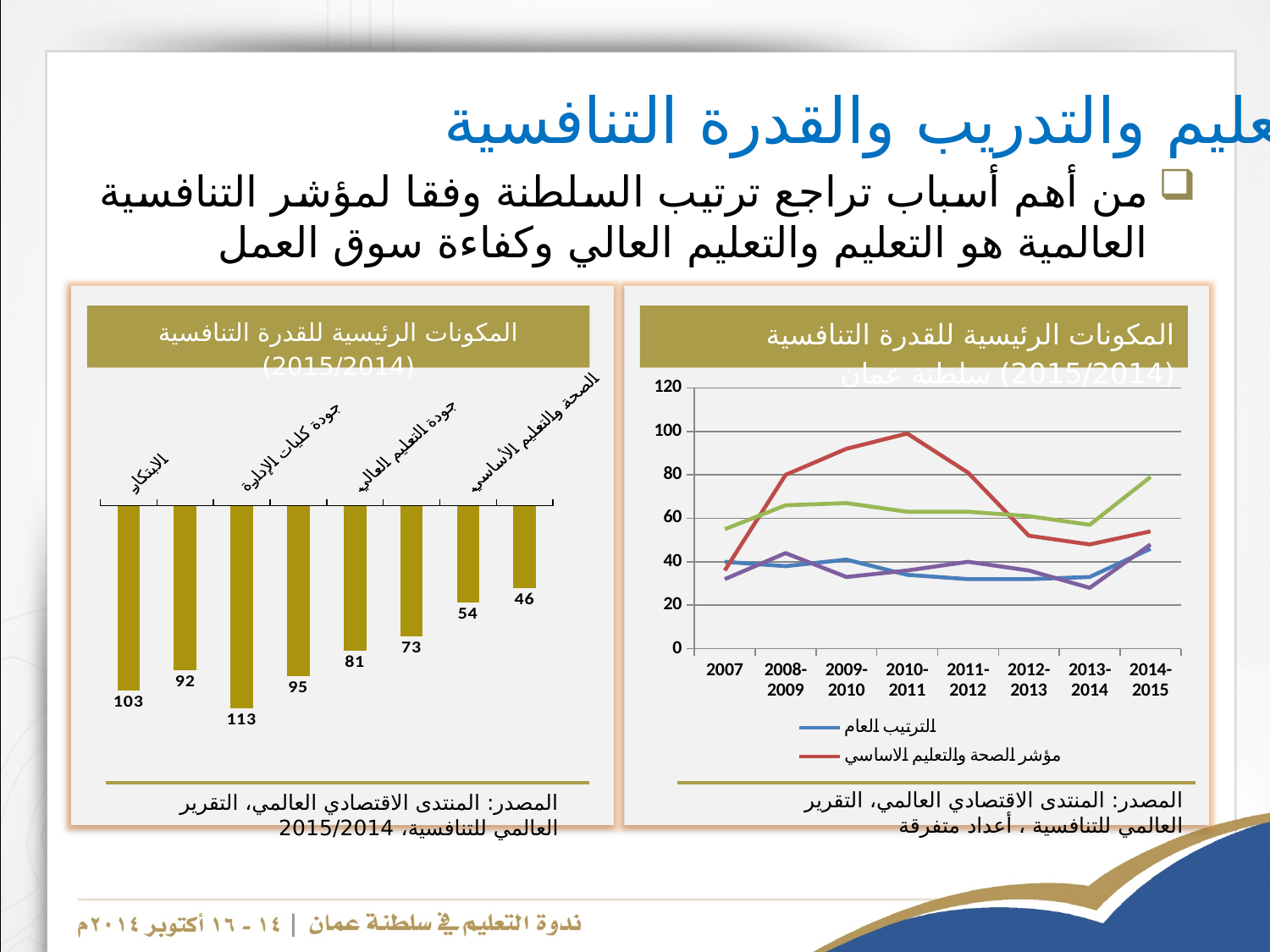
How many points are shown along the x axis of the right line chart? 8 In the left bar chart, what is the value of the rightmost bar? 46 In the left bar chart, which is larger: the bar labelled 81 or the bar labelled 73? 81 In the left bar chart, what is the lowest value shown on any bar? 46 In the left bar chart, what is the highest value shown on any bar? 113 In the right line chart, in which period does the red line (مؤشر الصحة والتعليم الاساسي) reach its highest value? 2010-2011 What type of chart is the right chart titled 'المكونات الرئيسية للقدرة التنافسية (2015/2014) سلطنة عمان'? line chart In the left bar chart, what is the value of the leftmost bar? 103 What type of chart is the left chart titled 'المكونات الرئيسية للقدرة التنافسية (2015/2014)'? bar chart In the left bar chart, what is the difference between the highest bar value (113) and the lowest bar value (46)? 67 How many bars are plotted in the left bar chart? 8 In the right line chart, is the value of the red line (مؤشر الصحة والتعليم الاساسي) for 2010-2011 greater or less than 80? greater